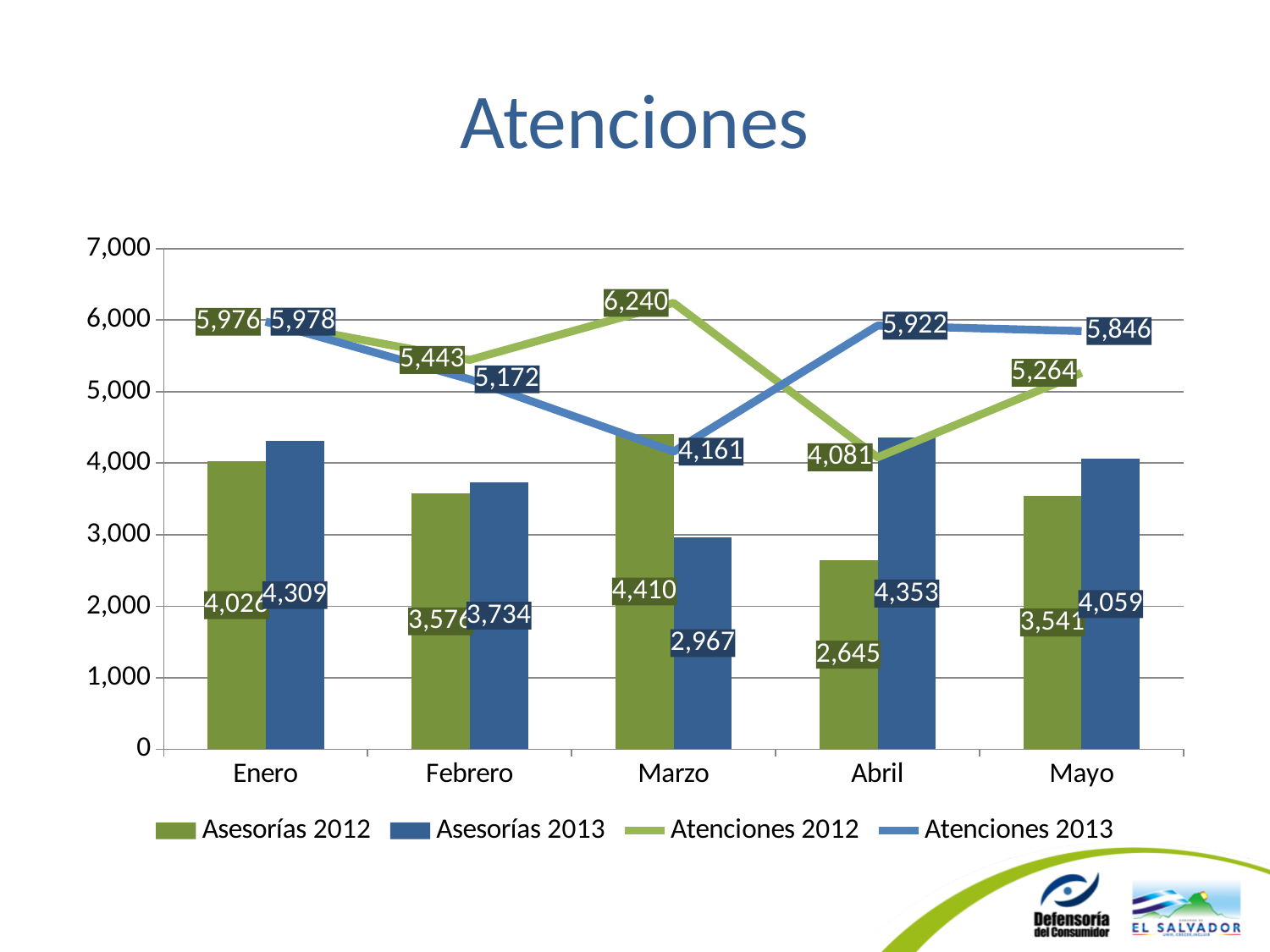
In which month is Asesorías 2012 lowest? Abril In which month is Asesorías 2013 lowest? Marzo What kind of chart is shown on the slide? Combined bar and line chart In which month is Atenciones 2012 highest? Marzo In Abril, which is larger: Asesorías 2012 or Asesorías 2013? Asesorías 2013 What is the difference between Atenciones 2013 in Abril and in Marzo? 1,761 What is the value of Asesorías 2013 for Marzo? 2,967 What is the value of Atenciones 2012 for Marzo? 6,240 How many months are shown on the x axis? 5 Is the value of Asesorías 2012 for Marzo greater or less than 4,000? greater What is the value of Atenciones 2013 for Mayo? 5,846 How many series does the legend list? 4